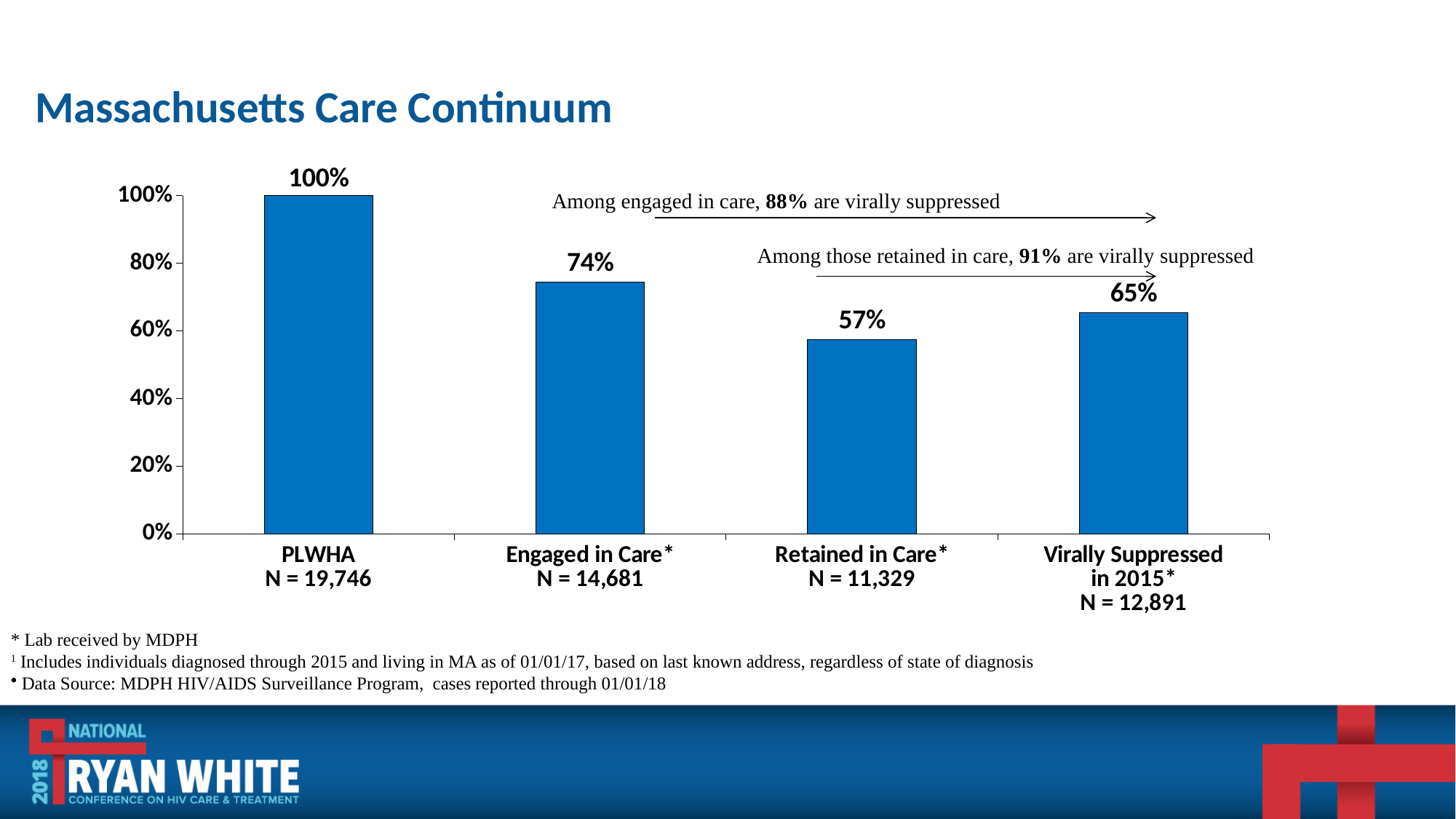
What is the value for Virally Suppressed in 2015? 65% What is the value for PLWHA? 100% How many bars are shown in the chart? 4 What is the difference between the values for PLWHA and Virally Suppressed in 2015? 35% What is the difference between the values for Engaged in Care and Retained in Care? 17% Which category has the highest value? PLWHA What is the N value shown for Retained in Care? N = 11,329 What is the value for Engaged in Care? 74% What is the value for Retained in Care? 57% Which category has the lowest value? Retained in Care Which is larger, the value for Engaged in Care or the value for Virally Suppressed in 2015? Engaged in Care What kind of chart is shown on the slide? Bar chart